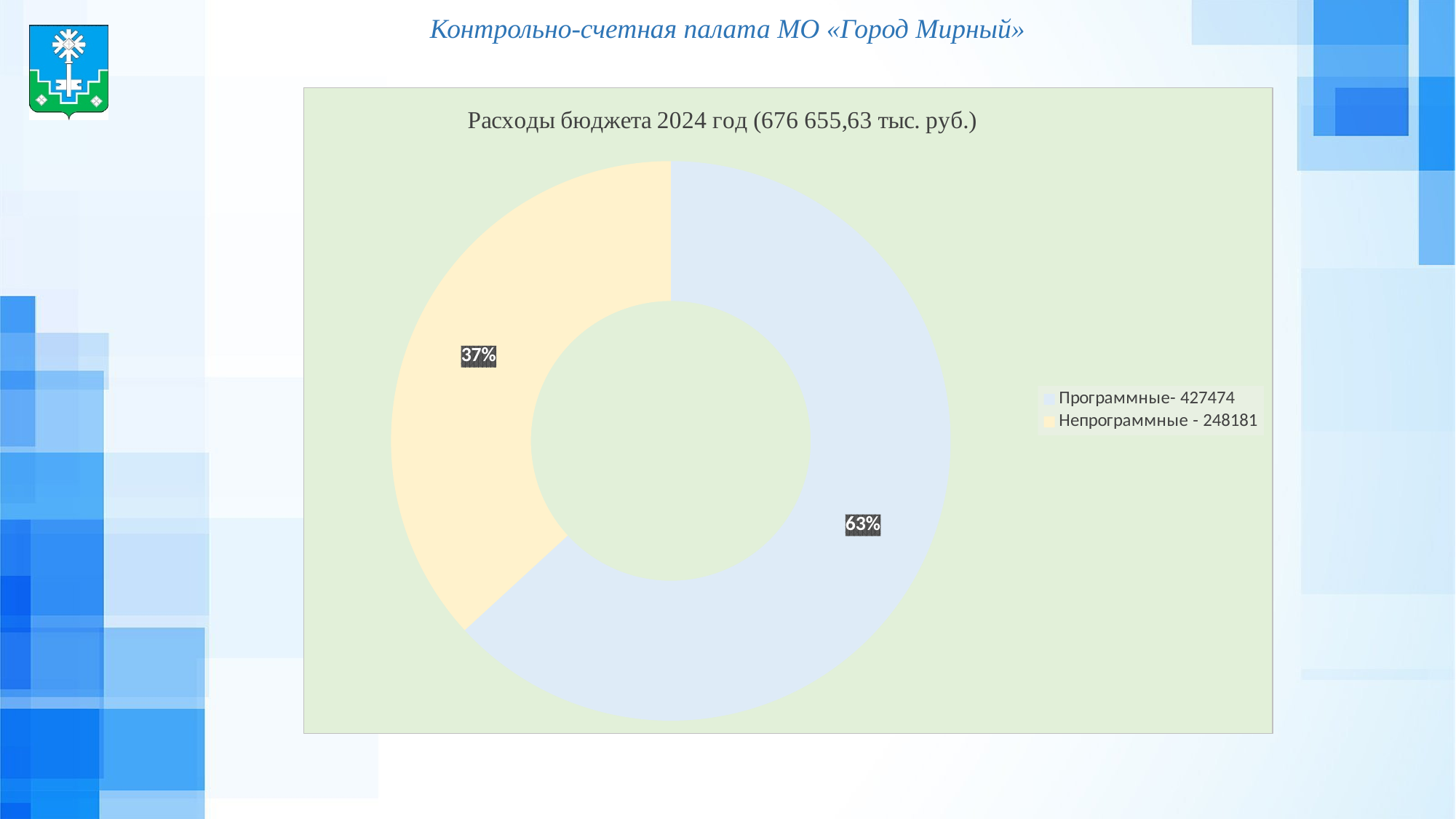
Which is larger, the Программные share or the Непрограммные share? Программные What value is given for Непрограммные in the legend? 248181 Which category has the largest share of the chart? Программные What is the difference in percentage points between the Программные and Непрограммные shares? 26 percentage points What colour is the Непрограммные slice? Light yellow Which category has the smallest share of the chart? Непрограммные What share of the chart does the Непрограммные slice represent? 37% What kind of chart is shown on the slide? Doughnut (pie) chart What share of the chart does the Программные slice represent? 63% What is the title of the chart? Расходы бюджета 2024 год (676 655,63 тыс. руб.) How many categories does the chart show? 2 What value is given for Программные in the legend? 427474